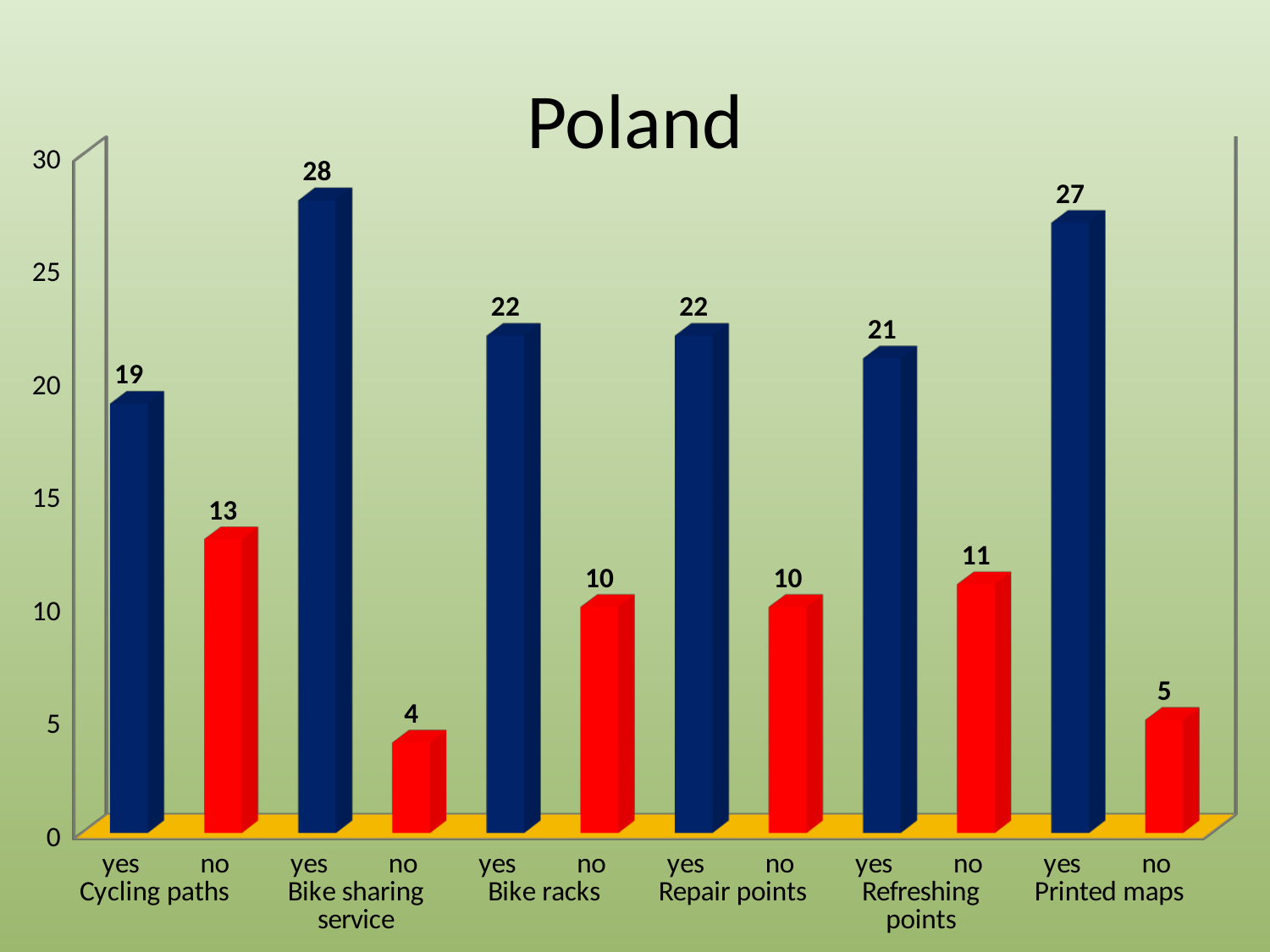
Which category has the lowest 'no' value? Bike sharing service Which category has the highest 'yes' value? Bike sharing service How many categories are shown on the x axis? 6 What is the value of the 'no' bar for Bike sharing service? 4 What is the value of the 'yes' bar for Printed maps? 27 What is the title of the chart? Poland What is the value of the 'yes' bar for Cycling paths? 19 What is the difference between the 'yes' and 'no' values for Refreshing points? 10 What kind of chart is shown on the slide? bar chart What is the total of the 'yes' and 'no' values for Repair points? 32 Is the 'yes' value for Bike racks greater or less than 20? greater Which is larger: the 'no' value for Cycling paths or the 'no' value for Printed maps? Cycling paths